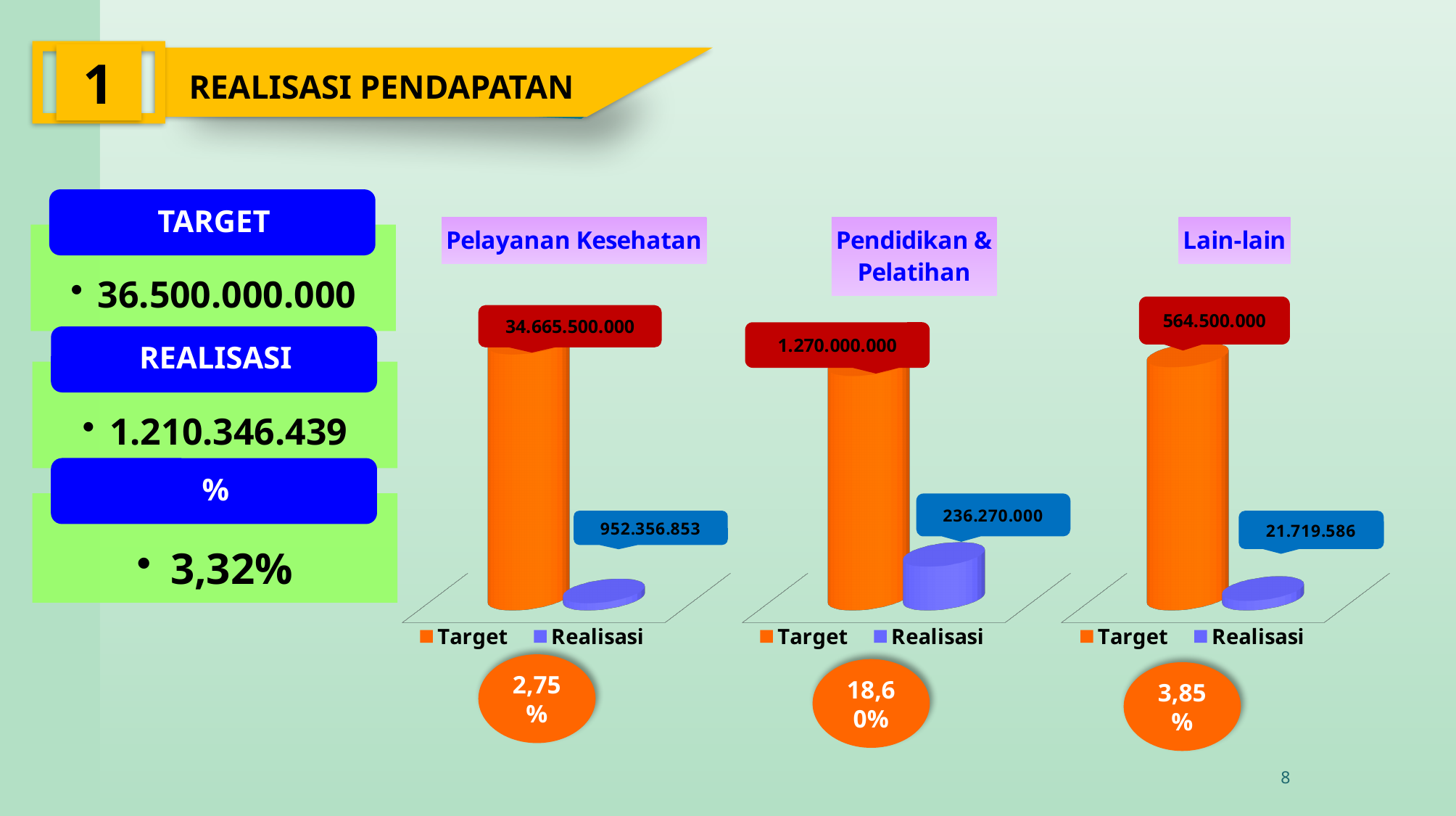
In the Pendidikan & Pelatihan chart, what is the value of Realisasi? 236.270.000 In the Pendidikan & Pelatihan chart, what is the difference between Target and Realisasi? 1.033.730.000 In the Pelayanan Kesehatan chart, what colour is the Target bar? Orange In the Pelayanan Kesehatan chart, what is the value of Target? 34.665.500.000 In the Pelayanan Kesehatan chart, which is larger, Target or Realisasi? Target How many series does the legend of the Lain-lain chart list? 2 In the Lain-lain chart, what is the value of Target? 564.500.000 In the Pendidikan & Pelatihan chart, what is the value of Target? 1.270.000.000 In the Lain-lain chart, what is the value of Realisasi? 21.719.586 In the Lain-lain chart, what is the difference between Target and Realisasi? 542.780.414 What kind of chart is the Pendidikan & Pelatihan chart? Bar chart In the Pelayanan Kesehatan chart, what is the value of Realisasi? 952.356.853